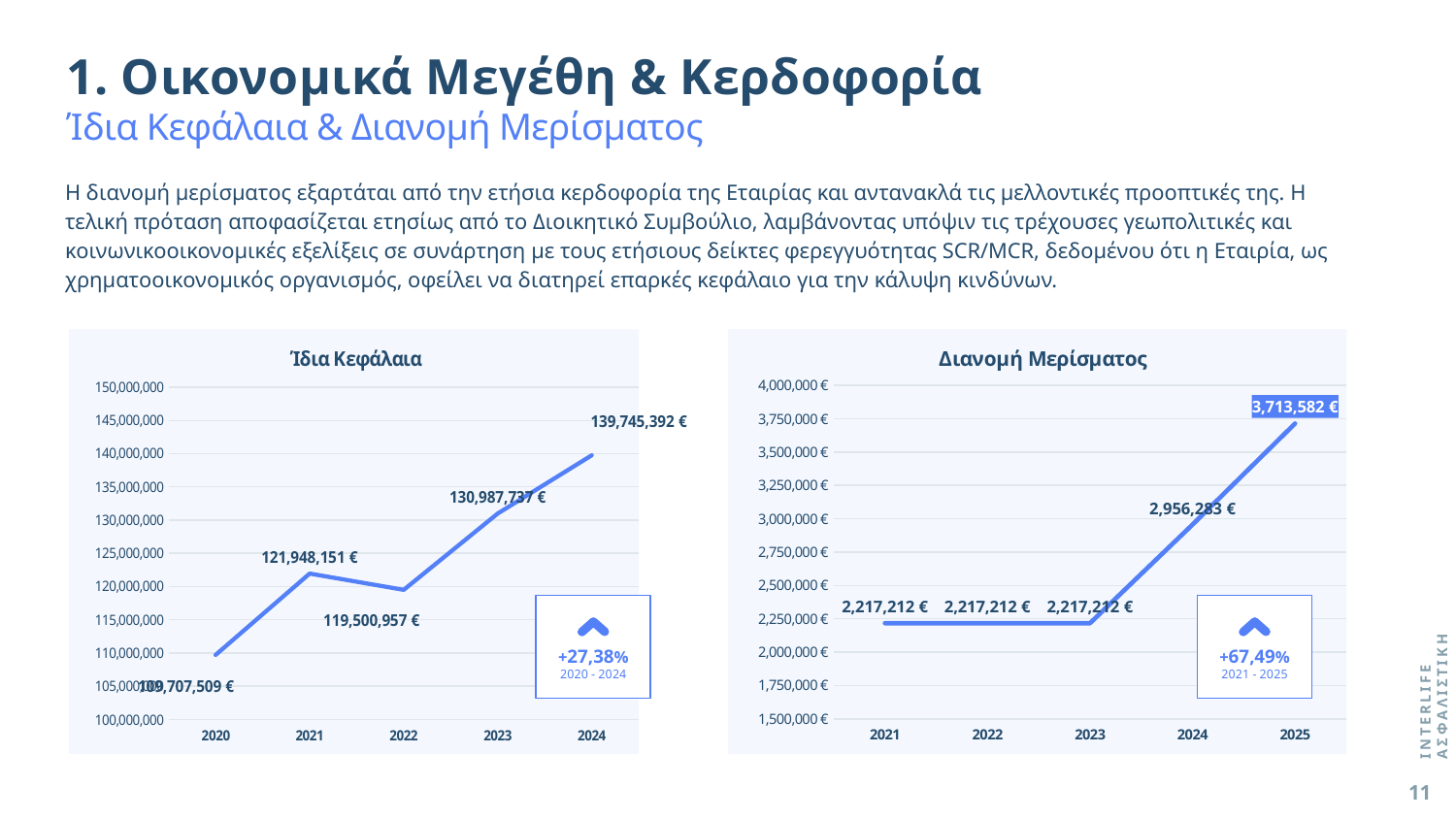
In the 'Ίδια Κεφάλαια' chart, which year has the lowest value? 2020 In the 'Διανομή Μερίσματος' chart, what is the difference between the 2025 value and the 2024 value? 757,299 € In the 'Ίδια Κεφάλαια' chart, how many years are plotted on the x axis? 5 What kind of chart is the 'Διανομή Μερίσματος' chart? Line chart In the 'Διανομή Μερίσματος' chart, what is the value for 2022? 2,217,212 € In the 'Ίδια Κεφάλαια' chart, what is the value for 2021? 121,948,151 € In the 'Ίδια Κεφάλαια' chart, what is the difference between the 2024 value and the 2023 value? 8,757,655 € In the 'Ίδια Κεφάλαια' chart, what is the value for 2024? 139,745,392 € In the 'Διανομή Μερίσματος' chart, what percentage change is shown in the callout box for 2021 - 2025? +67,49% In the 'Ίδια Κεφάλαια' chart, which is larger, the value for 2021 or the value for 2022? 2021 In the 'Διανομή Μερίσματος' chart, what is the value for 2025? 3,713,582 € In the 'Διανομή Μερίσματος' chart, which year has the highest value? 2025